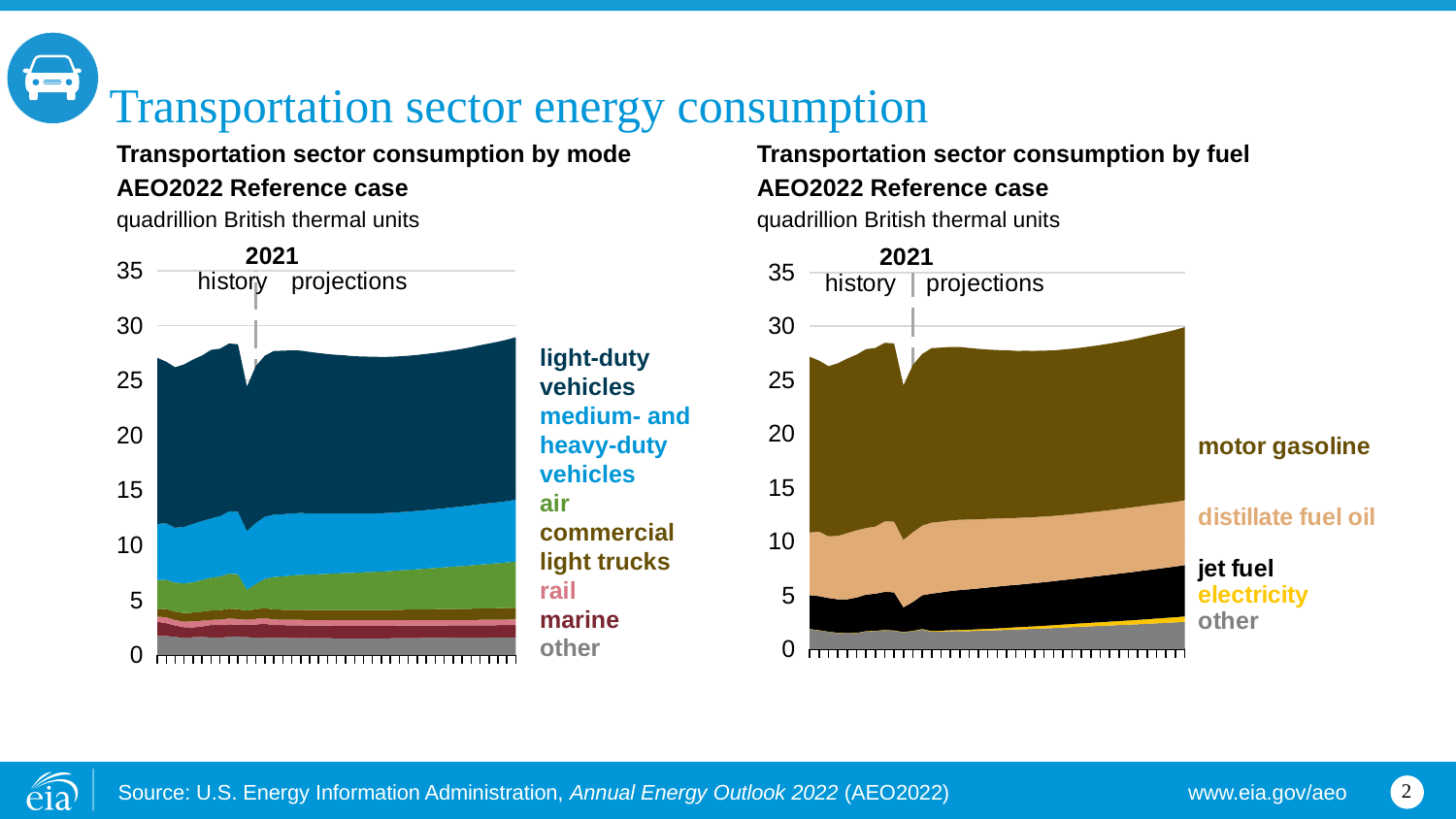
In the 'Transportation sector consumption by fuel' chart, which fuel accounts for the smallest share of consumption? electricity In the 'Transportation sector consumption by fuel' chart, which fuel accounts for the largest share of consumption? motor gasoline In the 'Transportation sector consumption by mode' chart, how many series (modes) are labeled? 7 In the 'Transportation sector consumption by fuel' chart, is total consumption at the end of the projection period greater or less than 25 quadrillion Btu? greater What unit is used on the y-axis of both charts? quadrillion British thermal units What kind of chart is the 'Transportation sector consumption by mode' chart on the left? stacked area chart In the 'Transportation sector consumption by fuel' chart, how many series (fuels) are labeled? 5 In the 'Transportation sector consumption by mode' chart, is total consumption at the end of the projection period greater or less than 25 quadrillion Btu? greater In the 'Transportation sector consumption by mode' chart, which mode accounts for the largest share of consumption? light-duty vehicles In the 'Transportation sector consumption by mode' chart, is consumption by light-duty vehicles larger or smaller than consumption by air? larger What year separates history from projections in both charts? 2021 What kind of chart is the 'Transportation sector consumption by fuel' chart on the right? stacked area chart